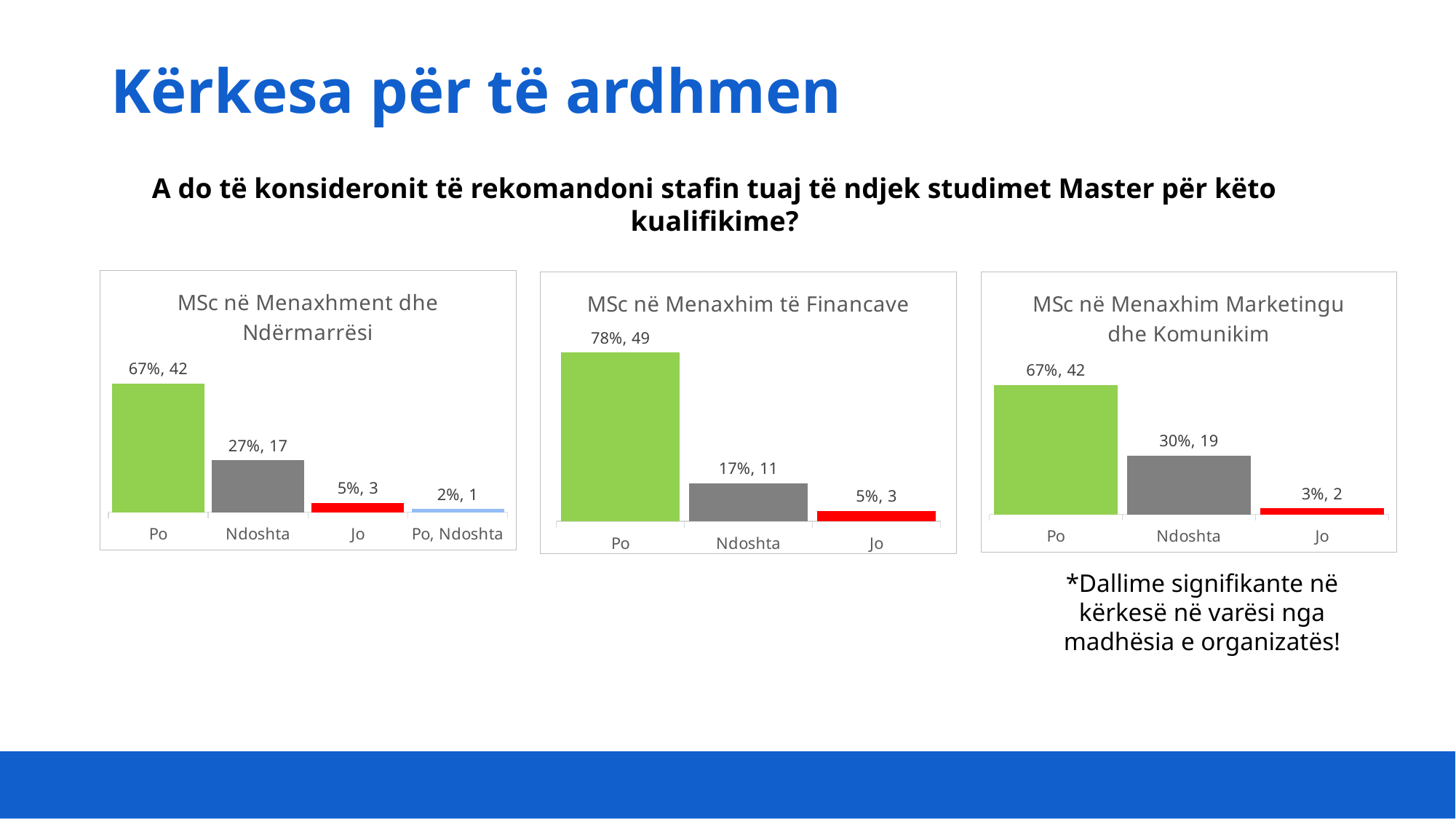
In the 'MSc në Menaxhim të Financave' chart, what is the difference in percentage between Po and Ndoshta? 61% In the 'MSc në Menaxhim Marketingu dhe Komunikim' chart, what is the data label for Jo? 3%, 2 What type of chart is the 'MSc në Menaxhim Marketingu dhe Komunikim' chart? Bar chart In the 'MSc në Menaxhment dhe Ndërmarrësi' chart, what is the data label for Po? 67%, 42 In the 'MSc në Menaxhim të Financave' chart, what is the data label for Ndoshta? 17%, 11 How many categories are shown in the 'MSc në Menaxhment dhe Ndërmarrësi' chart? 4 Which is larger: the Ndoshta count in the 'MSc në Menaxhim Marketingu dhe Komunikim' chart or the Ndoshta count in the 'MSc në Menaxhment dhe Ndërmarrësi' chart? MSc në Menaxhim Marketingu dhe Komunikim In the 'MSc në Menaxhim të Financave' chart, what colour is the Jo bar? Red In the 'MSc në Menaxhim të Financave' chart, which category has the highest value? Po In the 'MSc në Menaxhment dhe Ndërmarrësi' chart, which category has the lowest value? Po, Ndoshta How many categories are shown in the 'MSc në Menaxhim të Financave' chart? 3 In the 'MSc në Menaxhim Marketingu dhe Komunikim' chart, what is the difference in count between Po and Ndoshta? 23